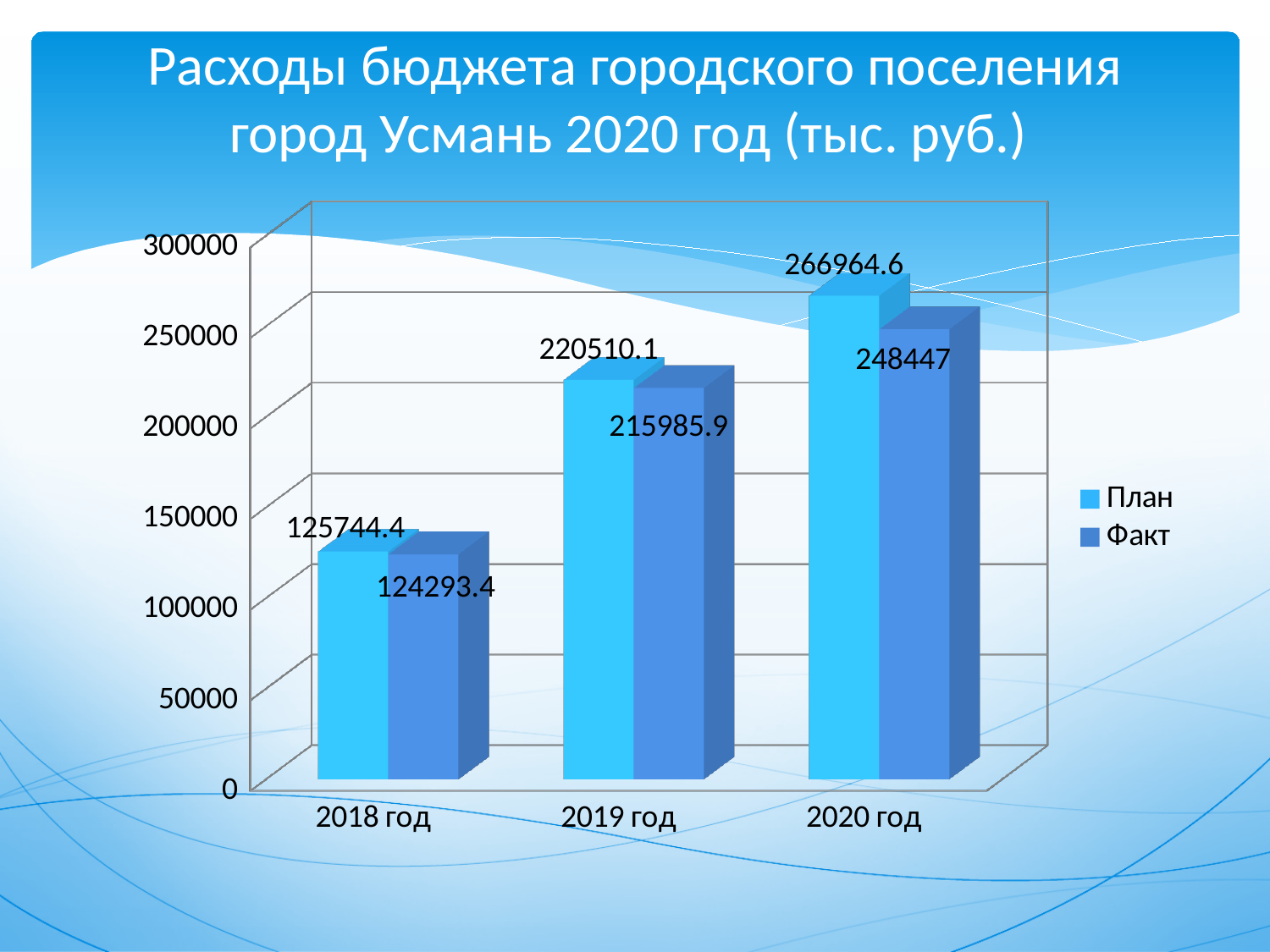
Do the План values rise or fall from 2018 год to 2020 год? rise Which is larger for 2020 год, План or Факт? План How many series does the legend list? 2 What is the План value for 2019 год? 220510.1 What is the difference between the План and Факт values for 2019 год? 4524.2 What is the Факт value for 2020 год? 248447 Which year has the lowest Факт value? 2018 год What is the Факт value for 2018 год? 124293.4 Which year has the highest План value? 2020 год How many years are shown on the x axis? 3 Is the Факт value for 2019 год greater or less than 200000? greater What is the difference between the План and Факт values for 2020 год? 18517.6